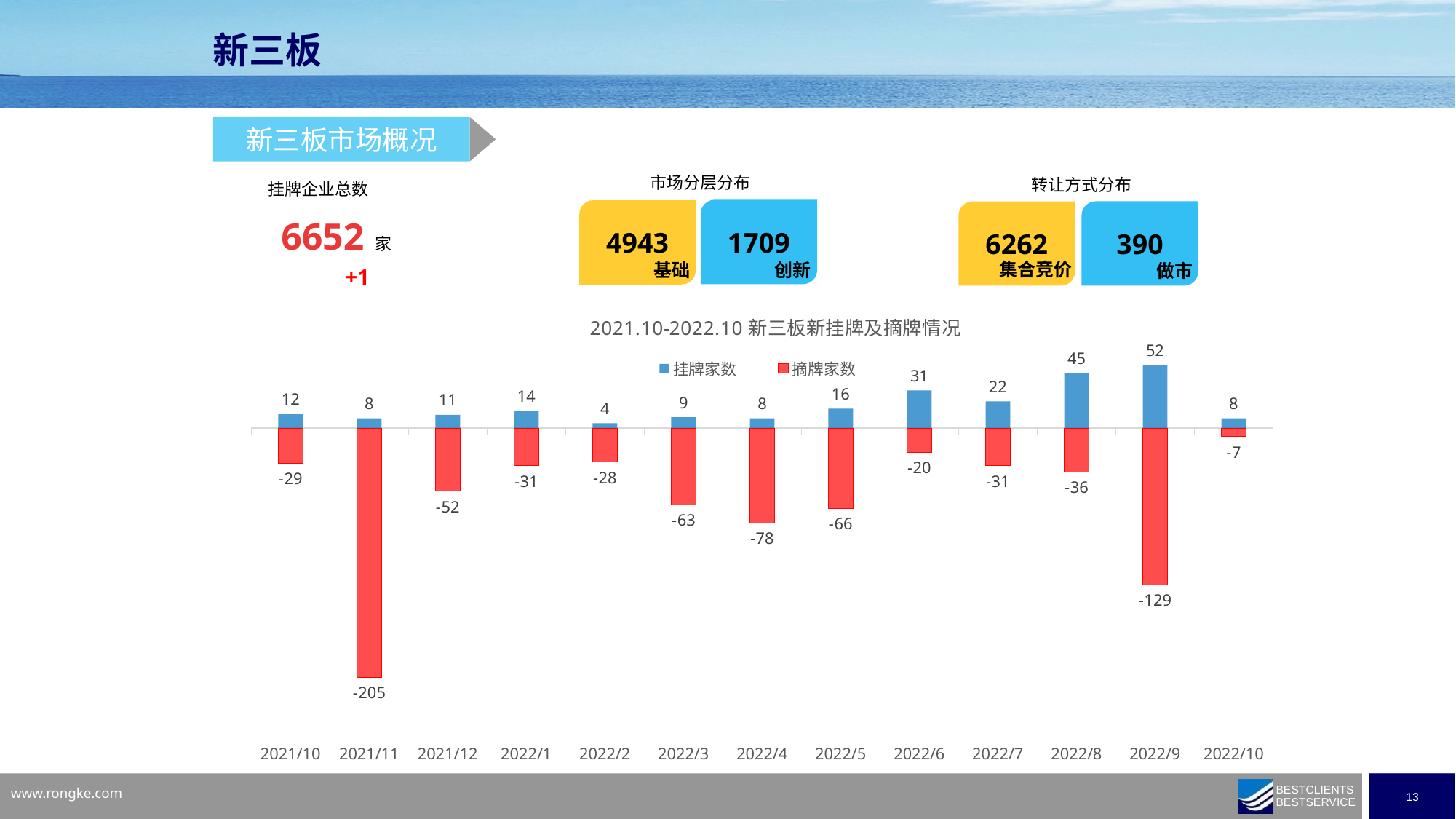
Which is larger in absolute terms, the 摘牌家数 for 2022/3 or for 2022/5? 2022/5 Which month has the largest number of 摘牌家数 (the longest red bar)? 2021/11 Which month has the lowest 挂牌家数? 2022/2 How many series does the chart legend list? 2 What is the 挂牌家数 value for 2022/9? 52 What is the title of the chart? 2021.10-2022.10 新三板新挂牌及摘牌情况 What is the 摘牌家数 value for 2021/11? -205 What kind of chart is used to show 新挂牌及摘牌情况? Bar chart Which month has the highest 挂牌家数? 2022/9 How many months are shown on the x axis of the chart? 13 What is the 摘牌家数 value for 2022/4? -78 What is the difference between the 挂牌家数 for 2022/9 and 2022/8? 7